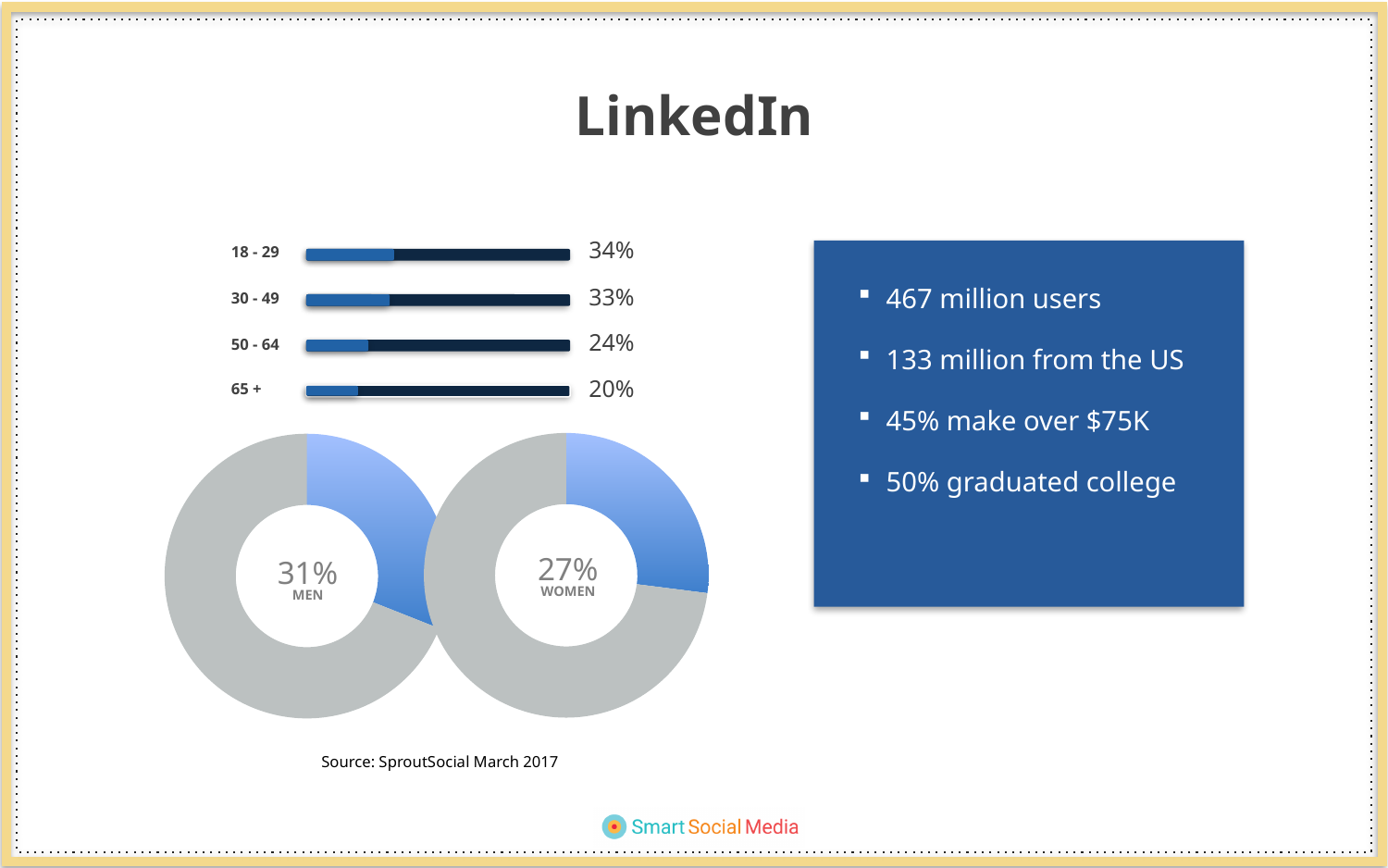
How many age groups are shown in the age-group bar chart? 4 In the age-group bar chart, what is the value for the 50 - 64 group? 24% What kind of chart is used to show the age groups? Bar chart In the age-group bar chart, which is larger: the value for 30 - 49 or the value for 50 - 64? 30 - 49 In the age-group bar chart, which age group has the lowest value? 65 + Which donut chart shows the larger percentage, MEN or WOMEN? MEN In the age-group bar chart, what is the value for the 65 + group? 20% In the age-group bar chart, which age group has the highest value? 18 - 29 In the age-group bar chart, do the values rise or fall as the age groups get older from 18 - 29 to 65 +? Fall In the age-group bar chart, what is the value for the 18 - 29 group? 34% In the age-group bar chart, what is the difference between the 18 - 29 value and the 65 + value? 14% In the donut chart labelled MEN, what percentage is shown? 31%